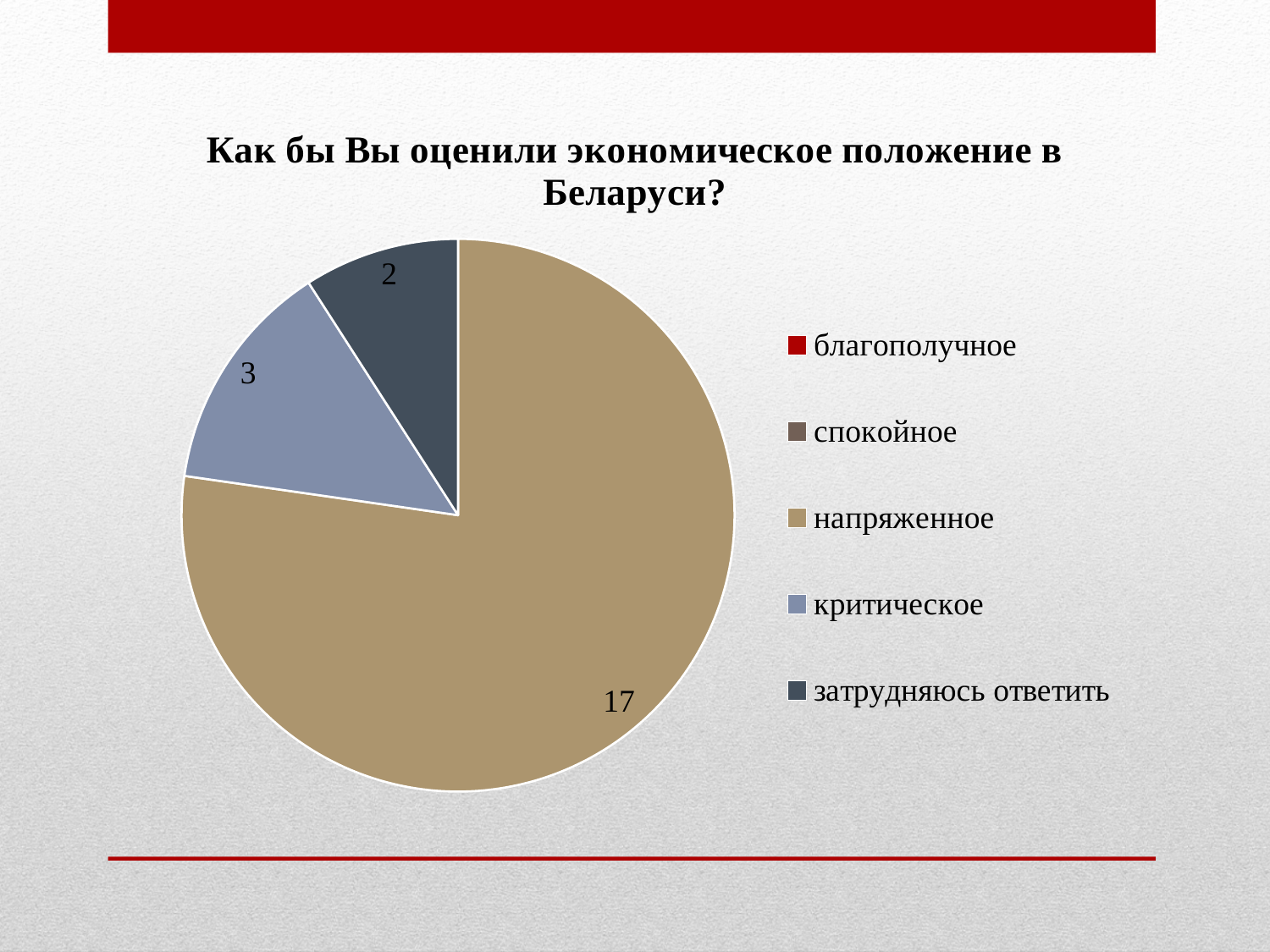
What is the value for затрудняюсь ответить? 2 What is the value for критическое? 3 How many categories does the legend list? 5 What is the difference between the values for напряженное and критическое? 14 Which category has the largest slice of the pie? напряженное Which is larger, the value for критическое or the value for затрудняюсь ответить? критическое Which of the visible slices is the smallest? затрудняюсь ответить What is the value for напряженное? 17 What type of chart is shown on the slide? pie chart What is the difference between the values for критическое and затрудняюсь ответить? 1 Which legend entry is shown in red? благополучное What is the title of the chart? Как бы Вы оценили экономическое положение в Беларуси?